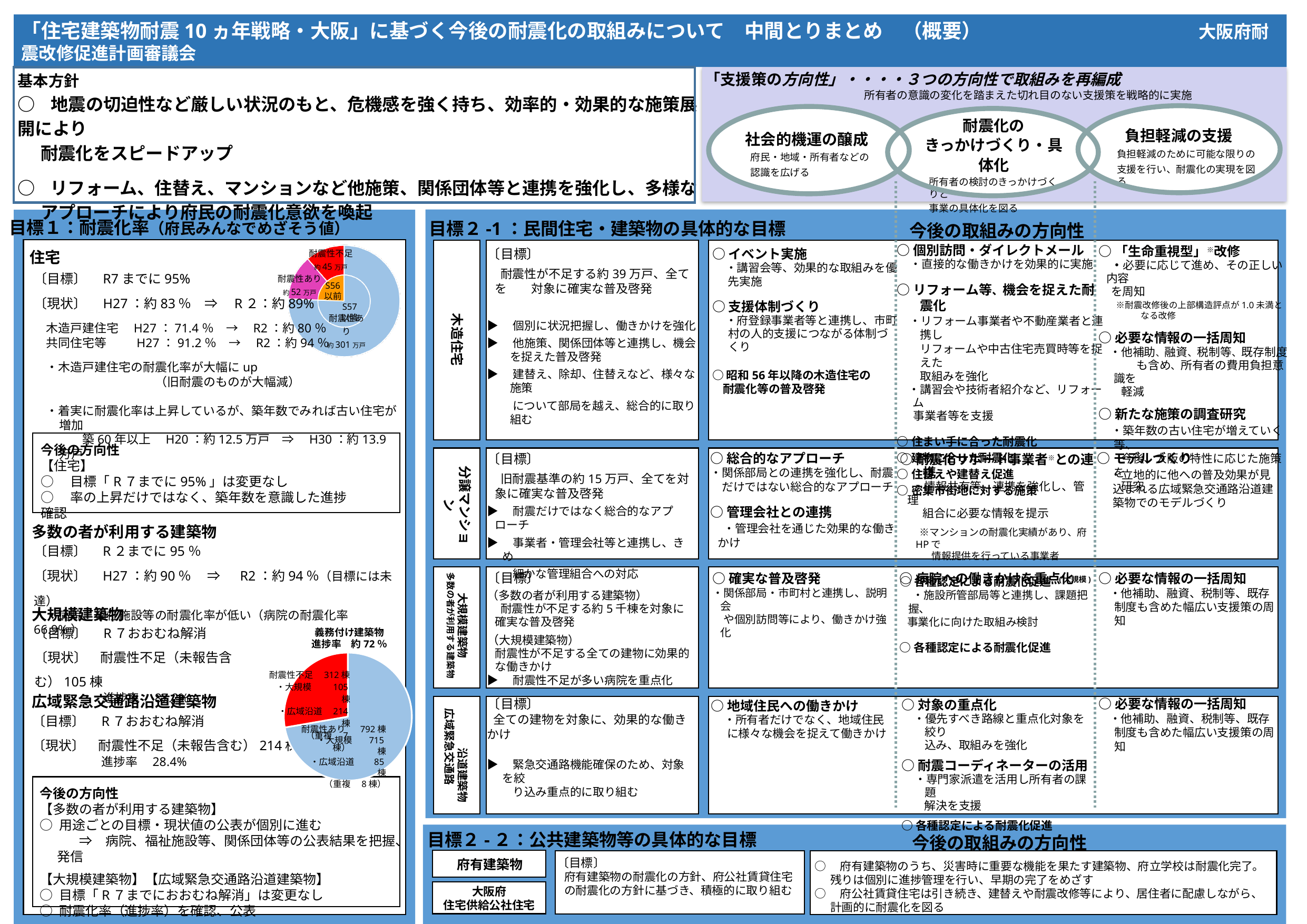
In the lower pie chart (義務付け建築物), what is the value for 耐震性不足? 312棟 In the lower pie chart (義務付け建築物), which is larger, 耐震性あり or 耐震性不足? 耐震性あり In the lower pie chart (義務付け建築物), what is the value for 耐震性あり? 792棟 What kind of chart is shown in the 住宅 section of 目標1 (the upper chart on the left)? pie chart In the upper pie chart (住宅), what is the value for the 耐震性あり slice of S56以前 housing? 約52万戸 In the upper pie chart (住宅), which slice is the largest? 耐震性あり（約301万戸） In the upper pie chart (住宅), what is the value for the 耐震性あり slice of S57以降 housing? 約301万戸 In the lower pie chart (義務付け建築物), what is the difference between 耐震性あり and 耐震性不足? 480棟 In the lower pie chart (義務付け建築物), how many 大規模 buildings are listed under 耐震性不足? 105棟 In the upper pie chart (住宅), which slice is the smallest? 耐震性不足（約45万戸） In the upper pie chart (住宅), what is the value for 耐震性不足? 約45万戸 What 進捗率 is printed above the lower pie chart (義務付け建築物)? 約72％